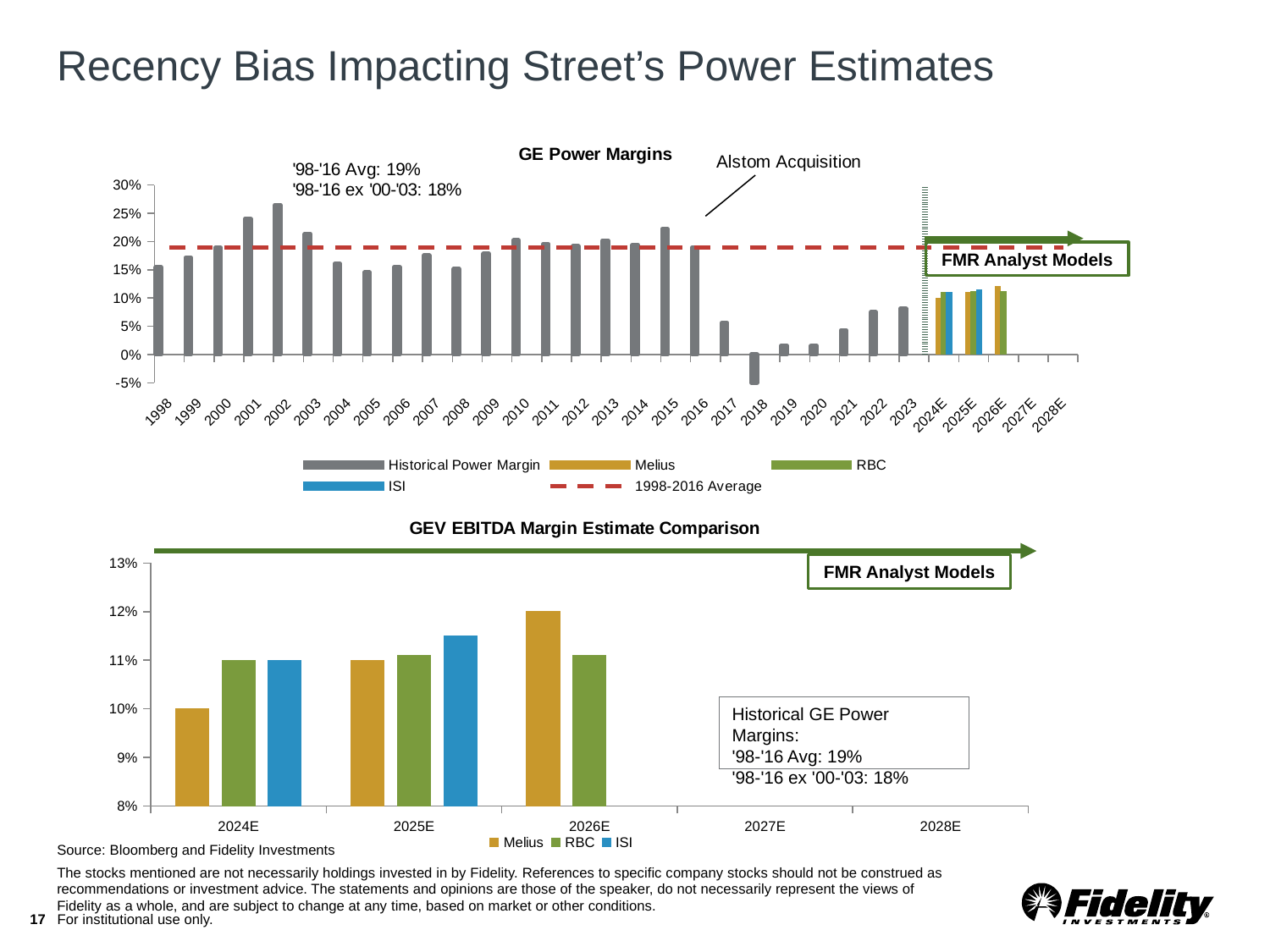
In the GE Power Margins chart, is the historical power margin for 2002 greater or less than 25%? greater How many series does the legend of the GEV EBITDA Margin Estimate Comparison chart list? 3 In the GEV EBITDA Margin Estimate Comparison chart, is the ISI estimate for 2025E larger or smaller than the Melius estimate for 2025E? larger In the GE Power Margins chart, is the historical power margin for 2017 greater or less than 10%? less In the GEV EBITDA Margin Estimate Comparison chart, which bar is the highest? Melius 2026E In the GE Power Margins chart, what does the red dashed line represent? 1998-2016 Average What kind of chart is the GE Power Margins chart? combination bar and line chart In the GEV EBITDA Margin Estimate Comparison chart, what is the Melius estimate for 2024E? 10% In the GE Power Margins chart, what is the '98-'16 average margin stated on the slide? 19% In the GE Power Margins chart, which year has the lowest historical power margin? 2018 In the GE Power Margins chart, which year has the highest historical power margin? 2002 How many series does the legend of the GE Power Margins chart list? 5